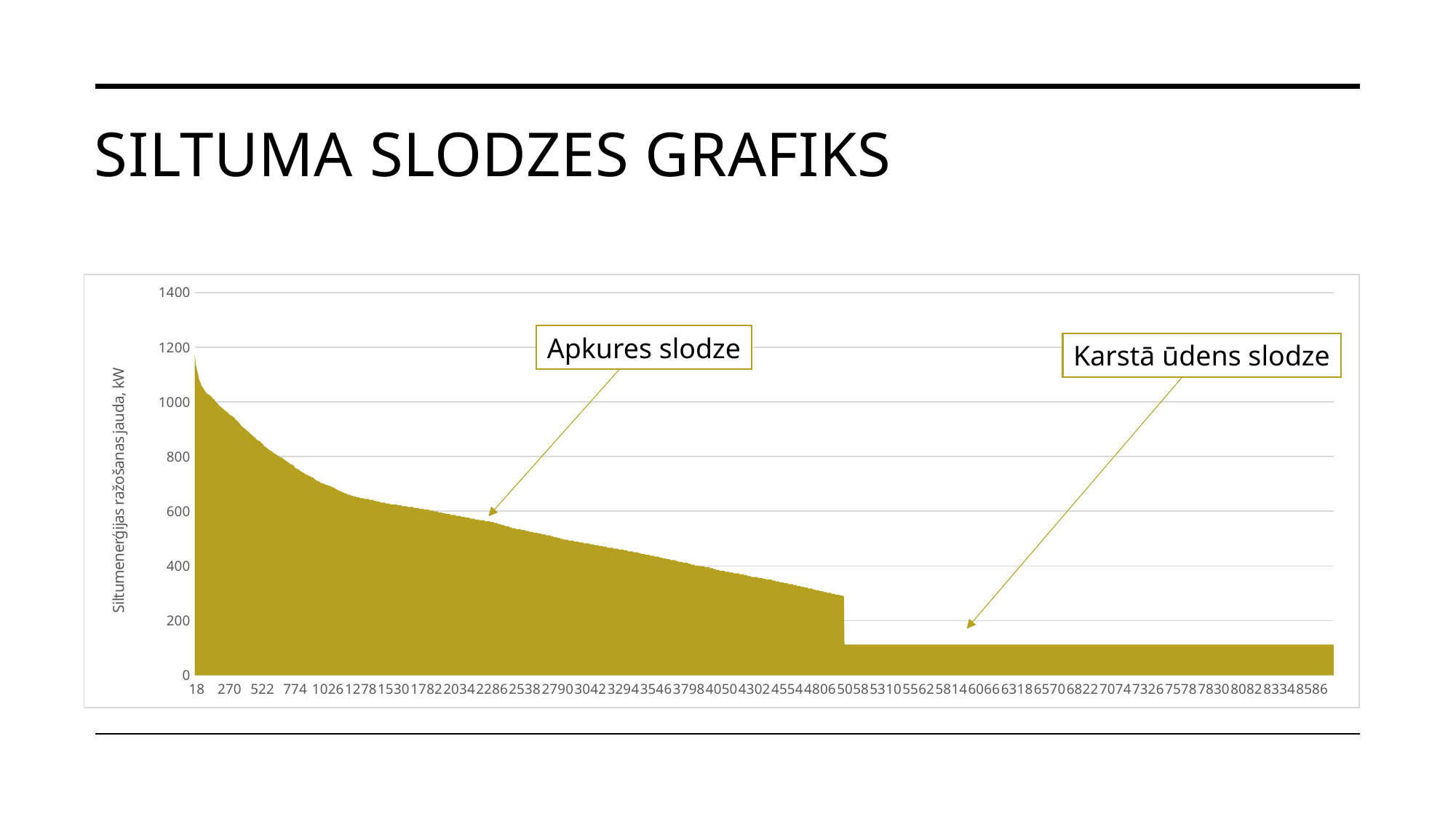
Is the value at x = 1026 greater or less than 600? greater Is the value at x = 6066 greater or less than 400? less What is the label of the vertical axis of the chart? Siltumenerģijas ražošanas jauda, kW Do the plotted values rise or fall as you move from left to right along the x axis? fall Is the value at the start of the curve (x = 18) greater or less than 1000? greater What is the title of the slide containing the chart? SILTUMA SLODZES GRAFIKS What is the highest tick value shown on the vertical axis? 1400 What kind of chart is shown on the slide? area chart Is the value at x = 18 larger or smaller than the value at x = 8586? larger